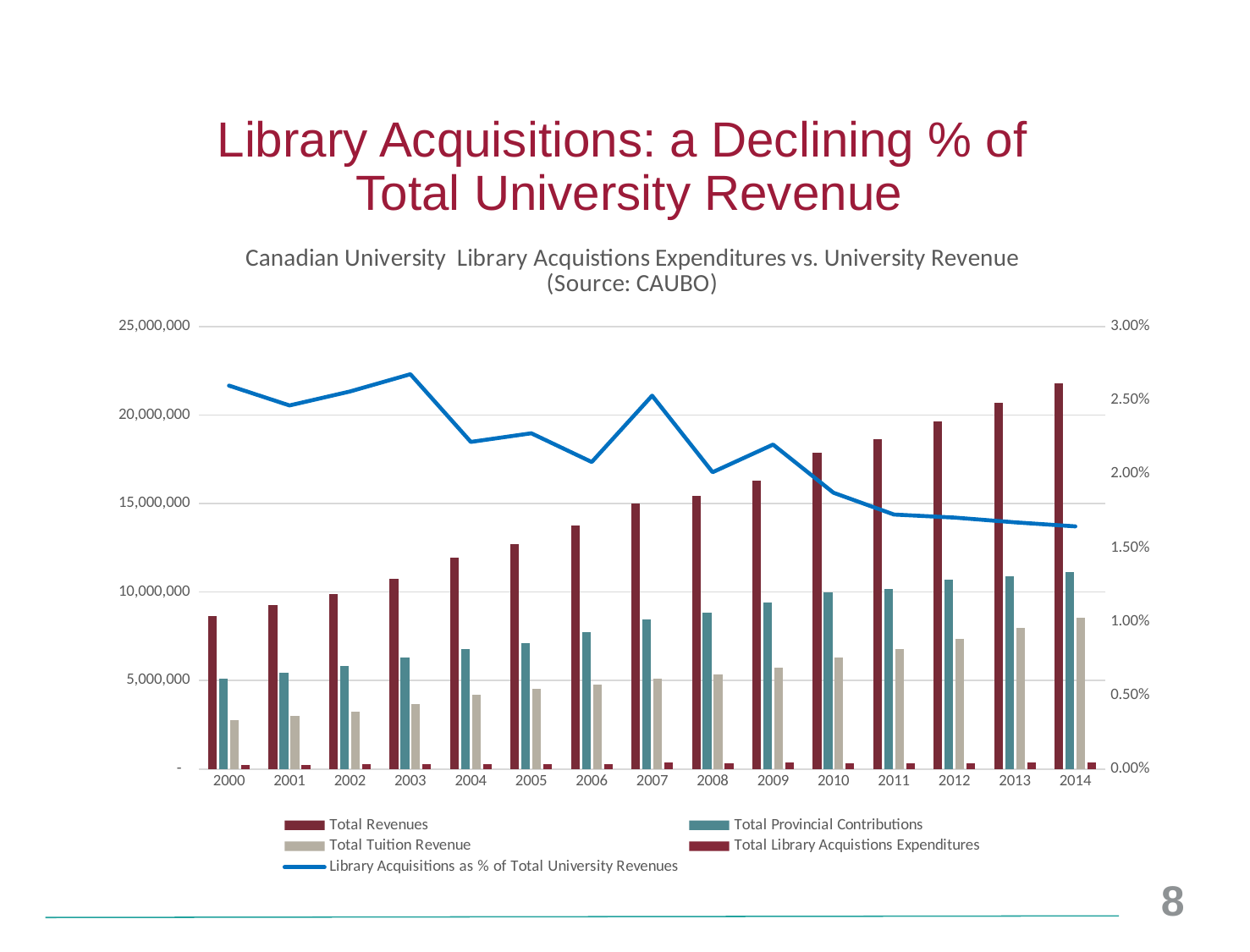
Which is larger in 2007: Total Revenues or Total Tuition Revenue? Total Revenues Is the value for Total Revenues in 2014 greater or less than 20,000,000? greater How many series does the legend list? 5 In which year does the Library Acquisitions as % of Total University Revenues line reach its lowest point? 2014 Is the Library Acquisitions as % of Total University Revenues value in 2003 greater or less than 2.50%? greater Does Total Revenues rise or fall from 2000 to 2014? Rise In which year is Total Revenues highest? 2014 In which year does the Library Acquisitions as % of Total University Revenues line reach its highest point? 2003 In which year is Total Revenues lowest? 2000 How many years are shown on the x axis? 15 Is the value for Total Provincial Contributions in 2014 greater or less than 10,000,000? greater What kind of chart is shown on the slide? A combination bar and line chart